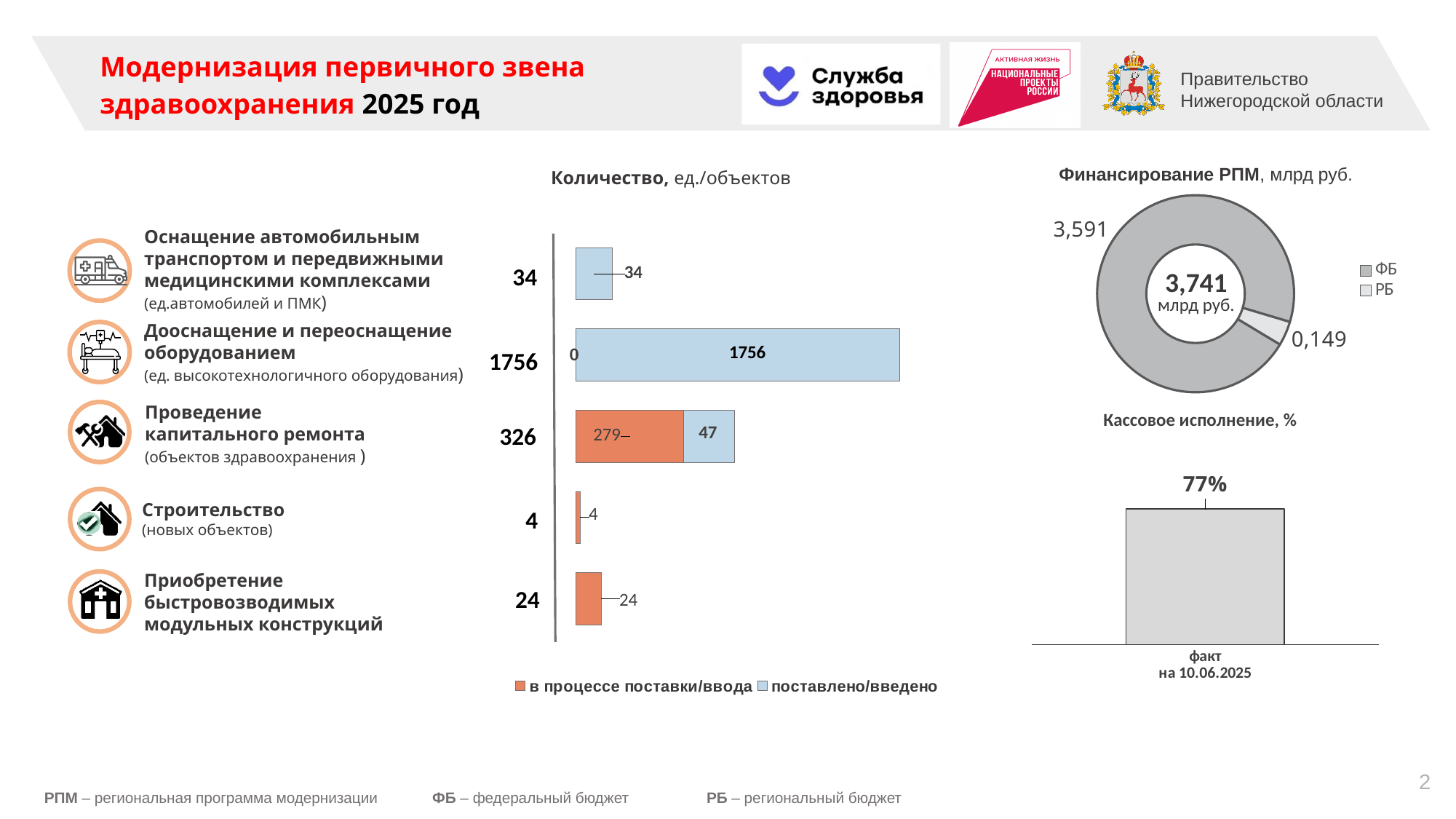
What type of chart is 'Количество, ед./объектов'? Bar chart In the 'Количество, ед./объектов' chart, what is the 'поставлено/введено' value for 'Дооснащение и переоснащение оборудованием'? 1756 In the 'Количество, ед./объектов' chart, how many categories are shown? 5 In the 'Количество, ед./объектов' chart, how many series does the legend list? 2 In the 'Финансирование РПМ, млрд руб.' chart, which is larger, ФБ or РБ? ФБ In the 'Количество, ед./объектов' chart, which category has the highest total value? Дооснащение и переоснащение оборудованием In the 'Кассовое исполнение, %' chart, what is the value for 'факт на 10.06.2025'? 77% In the 'Количество, ед./объектов' chart, what is the total for 'Проведение капитального ремонта'? 326 In the 'Финансирование РПМ, млрд руб.' chart, what is the value for ФБ? 3,591 In the 'Количество, ед./объектов' chart, which category has the lowest total value? Строительство In the 'Количество, ед./объектов' chart, what is the difference between the 'в процессе поставки/ввода' and 'поставлено/введено' values for 'Проведение капитального ремонта'? 232 In the 'Количество, ед./объектов' chart, what is the 'в процессе поставки/ввода' value for 'Проведение капитального ремонта'? 279